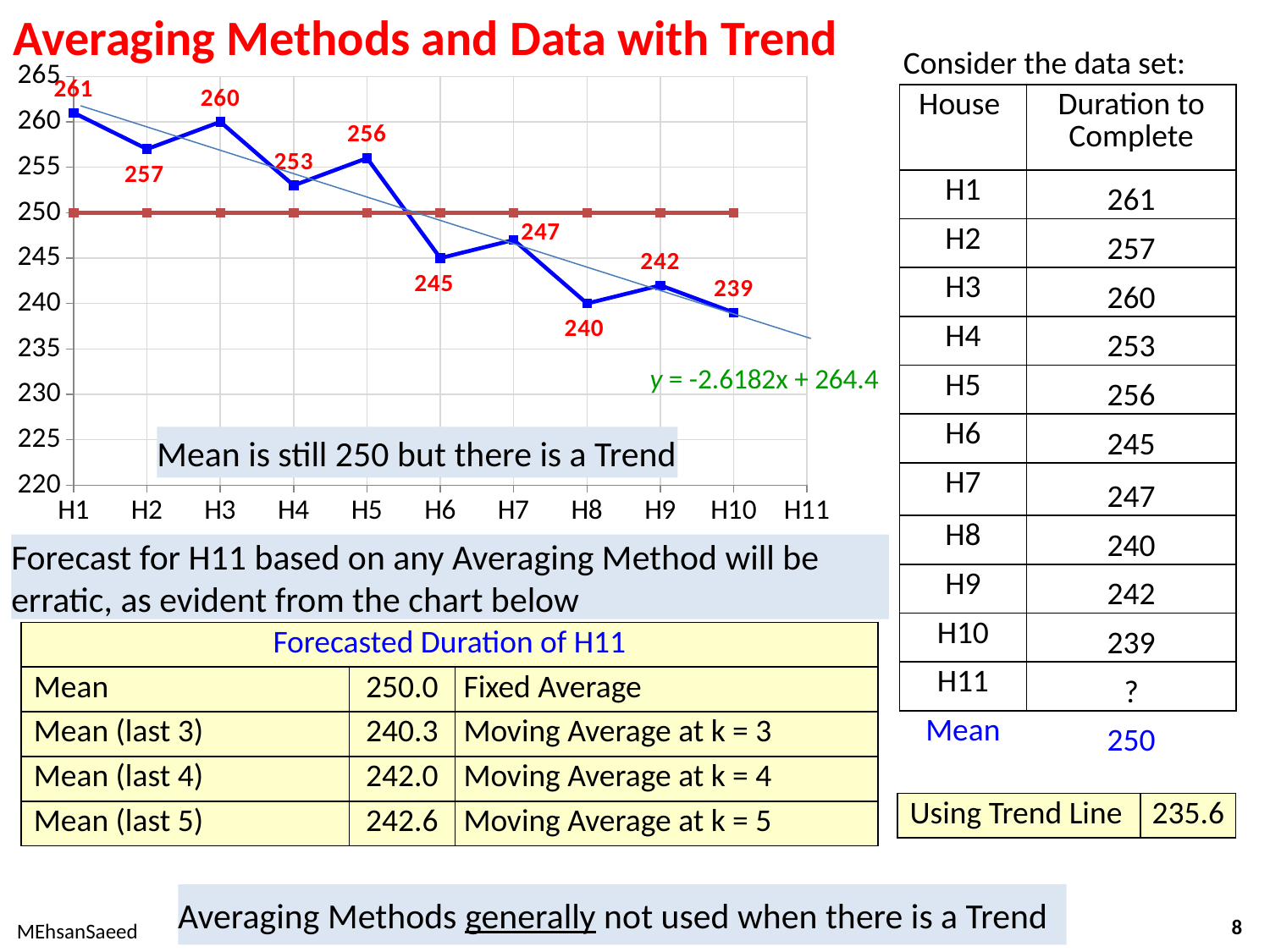
What kind of chart is shown on the slide? line chart What is the value plotted for H6 on the line chart? 245 What is the value plotted for H1 on the line chart? 261 What is the value plotted for H10 on the line chart? 239 What is the trend line equation shown on the chart? y = -2.6182x + 264.4 Which house has the highest plotted value on the line chart? H1 How many houses have data points plotted on the blue line in the chart? 10 What is the difference between the values for H1 and H10 on the line chart? 22 Is the value for H8 on the line chart greater or less than 250? less Which is larger on the line chart, the value for H3 or the value for H5? H3 Do the plotted values generally rise or fall from H1 to H10? fall Which house has the lowest plotted value on the line chart? H10